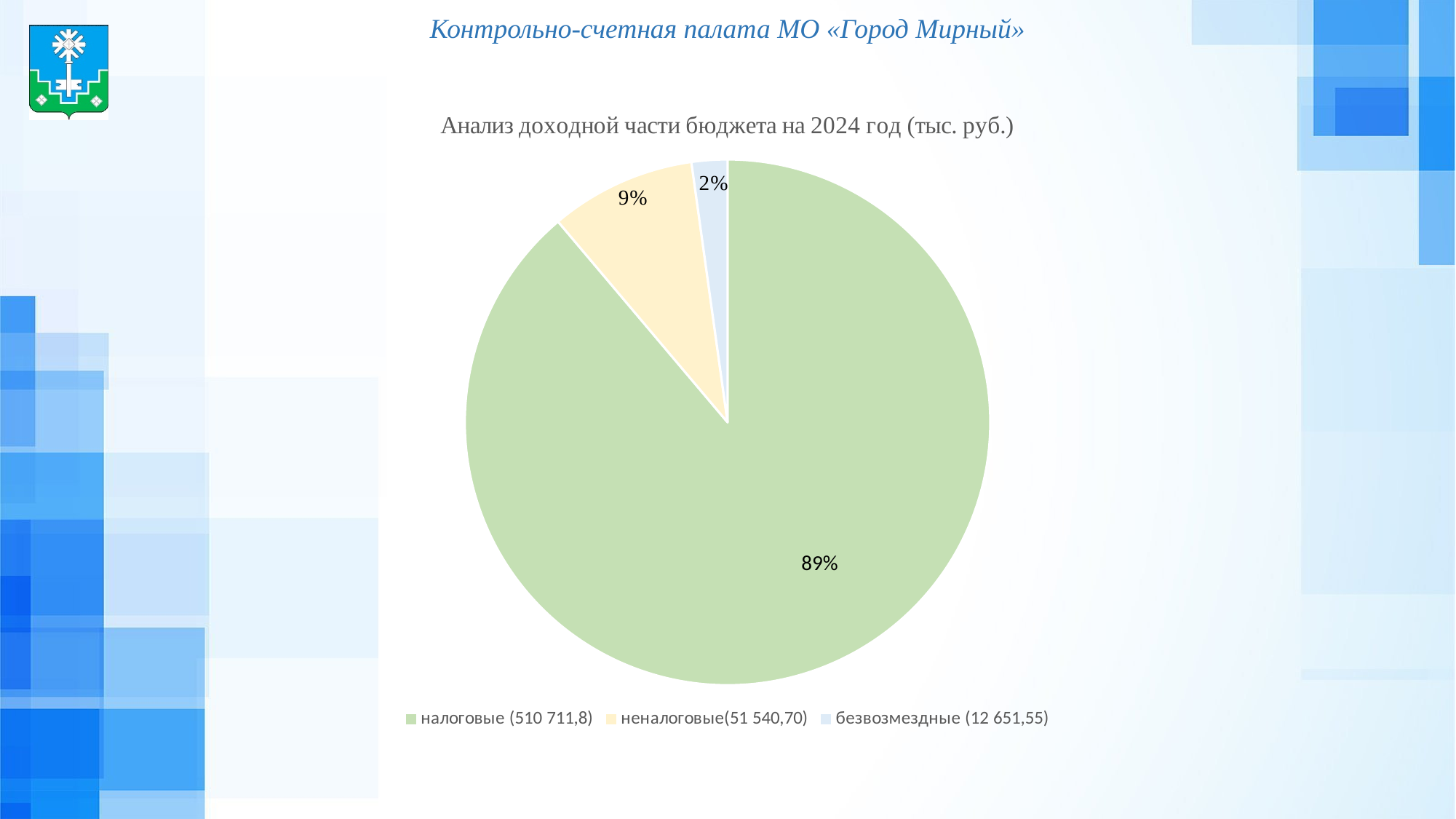
What share of the pie does the налоговые slice represent? 89% Which category has the smallest slice of the pie? безвозмездные What kind of chart is shown on the slide? pie chart Which slice is larger, неналоговые or безвозмездные? неналоговые Which category has the largest slice of the pie? налоговые What is the difference in percentage points between the налоговые and неналоговые slices? 80 What value is shown in the legend for налоговые? 510 711,8 What colour is the безвозмездные slice? light blue What is the title of the chart? Анализ доходной части бюджета на 2024 год (тыс. руб.) How many slices does the pie chart have? 3 What share of the pie does the безвозмездные slice represent? 2% What share of the pie does the неналоговые slice represent? 9%